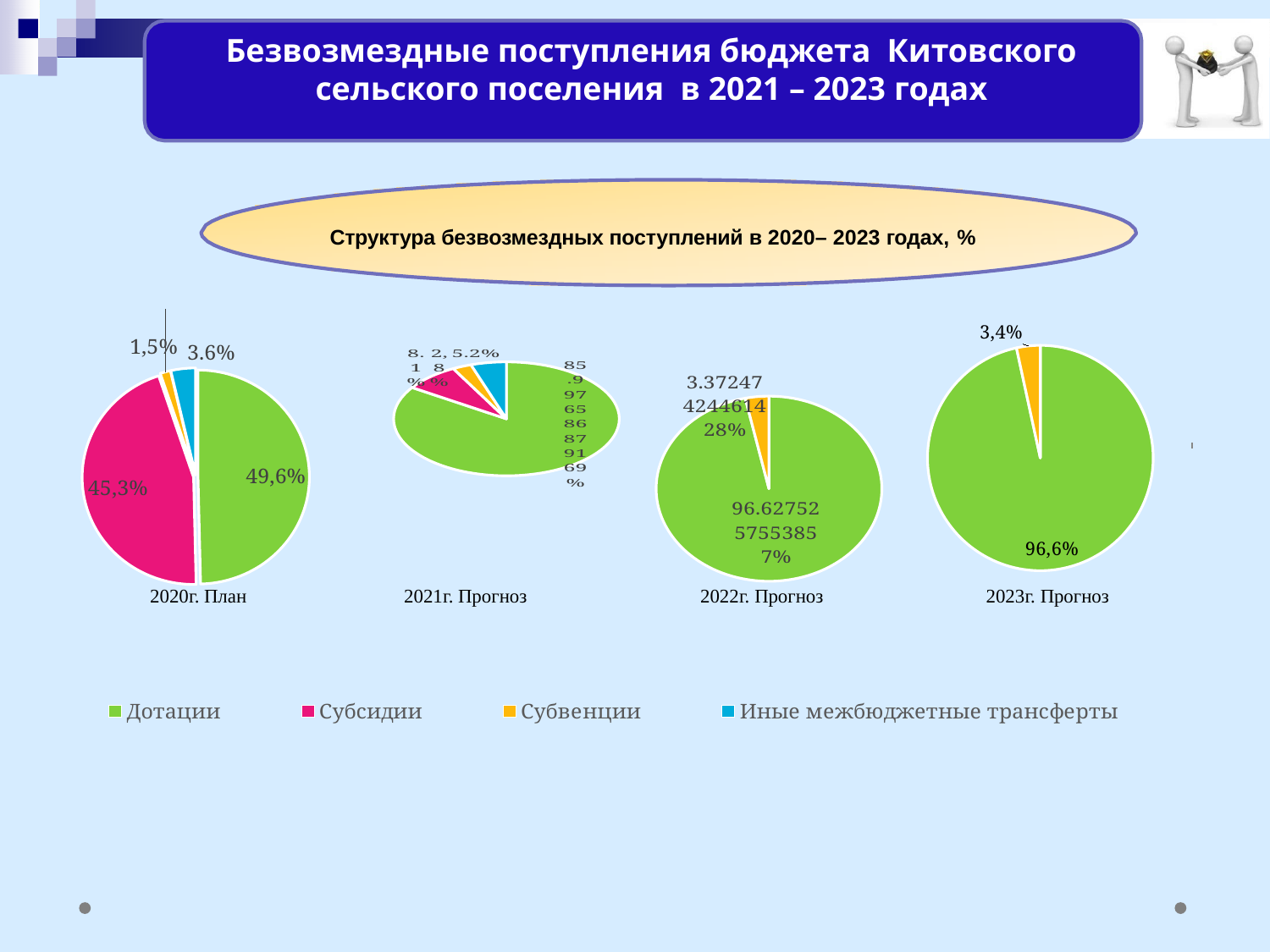
In the 2020г. План pie chart, which is larger: Дотации or Субсидии? Дотации How many slices does the 2023г. Прогноз pie chart have? 2 In the 2020г. План pie chart, what share is shown for Субсидии? 45,3% How many categories does the legend list for the pie charts? 4 In the 2023г. Прогноз pie chart, what share is shown for Дотации? 96,6% In the 2020г. План pie chart, what share is shown for Иные межбюджетные трансферты? 3.6% What type of chart is used for the 2022г. Прогноз data? Pie chart In the 2020г. План pie chart, which category has the smallest share? Субвенции In the 2020г. План pie chart, what share is shown for Дотации? 49,6% In the 2020г. План pie chart, what share is shown for Субвенции? 1,5% In the 2023г. Прогноз pie chart, what share is shown for Субвенции? 3,4% In the 2020г. План pie chart, which category has the largest share? Дотации